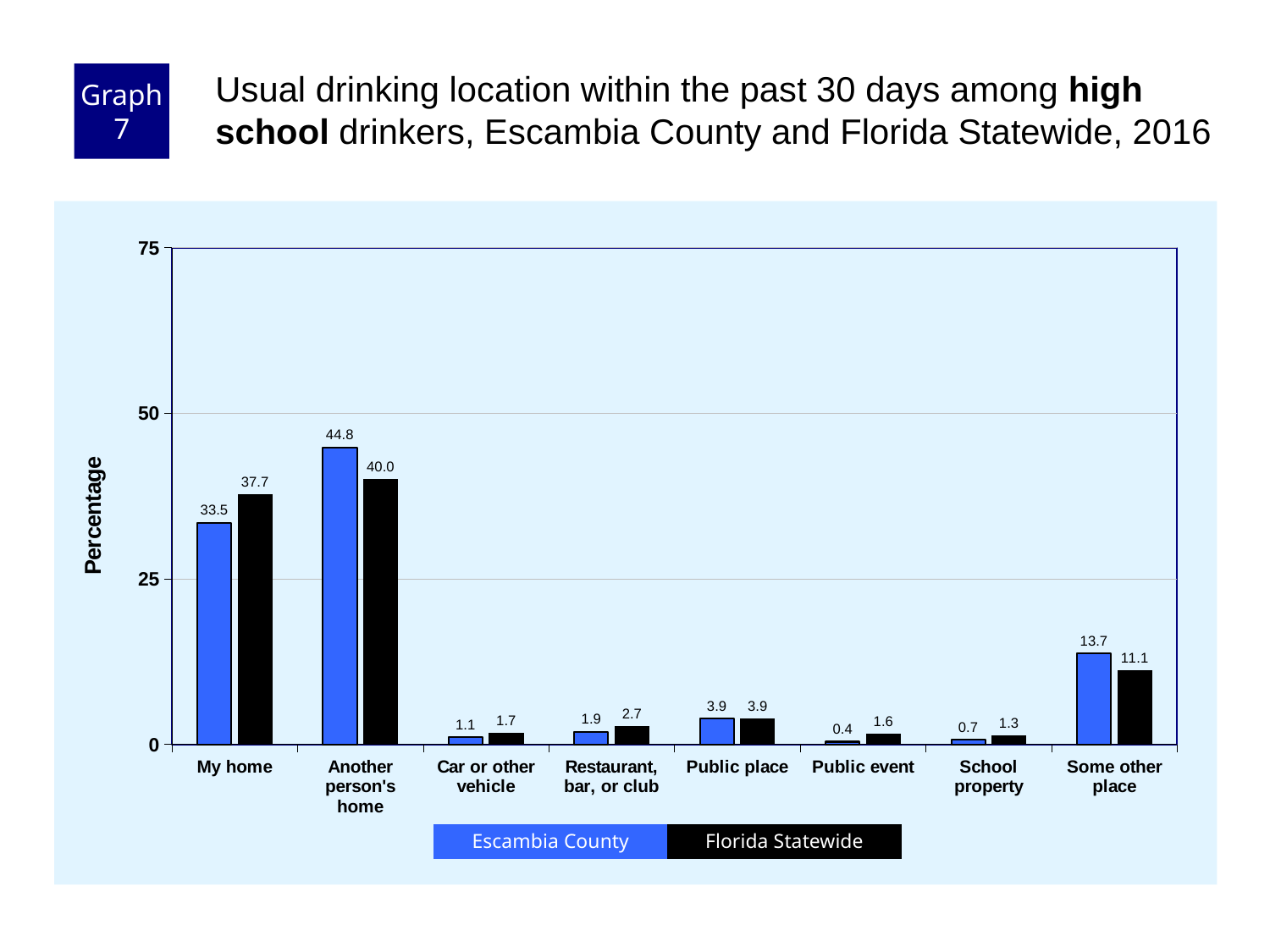
What kind of chart is shown on the slide? Bar chart How many location categories are shown on the x axis? 8 What is the Escambia County value for "Some other place"? 13.7 What is the Florida Statewide value for "My home"? 37.7 For "Some other place", which is larger: Escambia County or Florida Statewide? Escambia County What is the difference between the Escambia County and Florida Statewide values for "Another person's home"? 4.8 Is the Florida Statewide value for "Another person's home" greater or less than 25? greater Which category has the lowest Escambia County value? Public event Which category has the highest Escambia County value? Another person's home What is the difference between the Florida Statewide and Escambia County values for "My home"? 4.2 What is the Escambia County value for "Another person's home"? 44.8 How many series does the legend list? 2